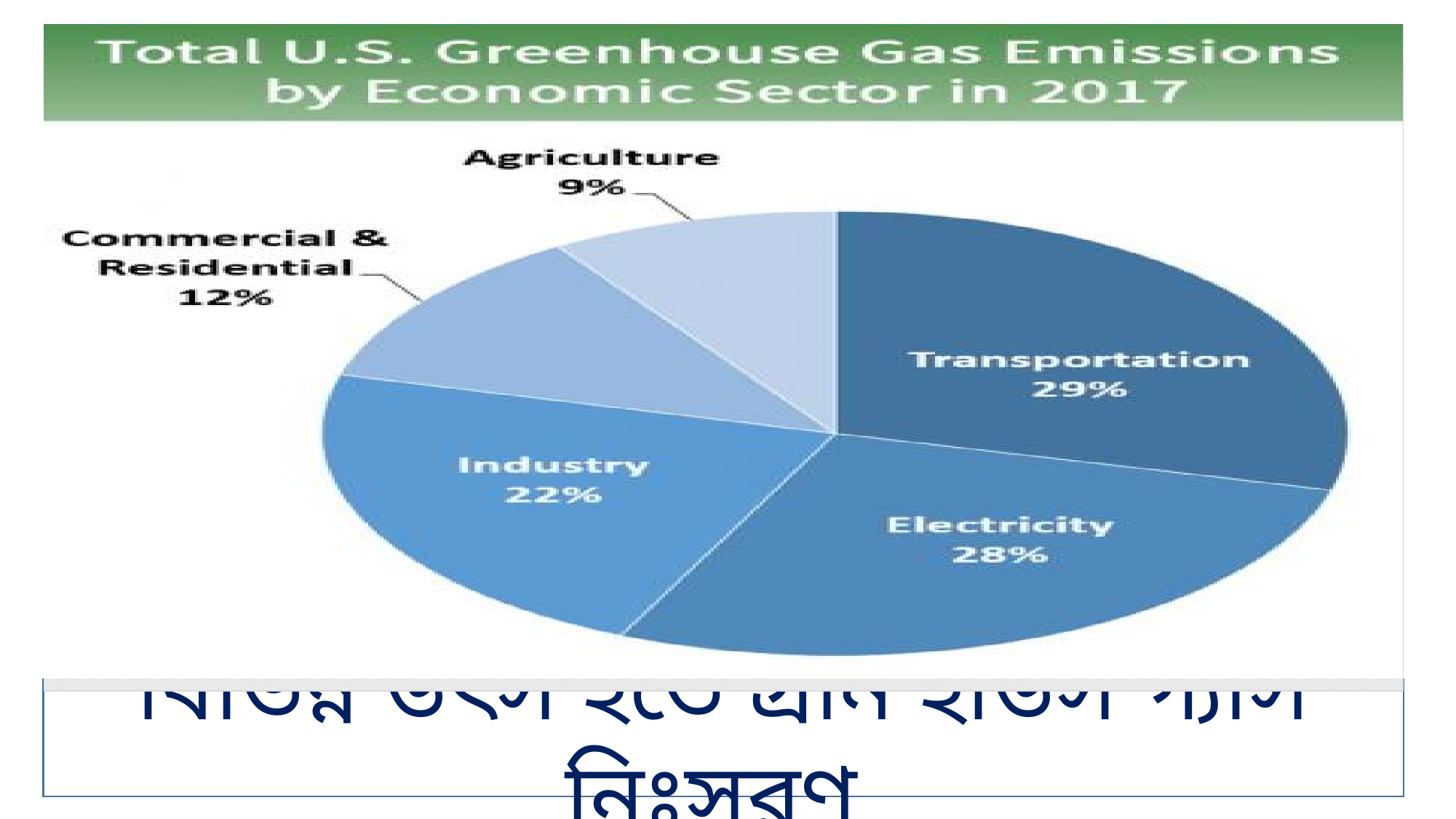
What kind of chart is shown on the slide? Pie chart What is the value shown for Industry? 22% What percentage of emissions is attributed to Electricity? 28% What is the title of the chart? Total U.S. Greenhouse Gas Emissions by Economic Sector in 2017 What percentage is shown for Commercial & Residential? 12% What is the difference in percentage points between Transportation and Industry? 7 What share does Agriculture account for? 9% Which economic sector has the smallest share of emissions? Agriculture What share of total U.S. greenhouse gas emissions in 2017 came from Transportation? 29% Which economic sector has the largest share of emissions? Transportation Which is larger, the share for Industry or the share for Commercial & Residential? Industry How many economic sectors are shown in the pie chart? 5